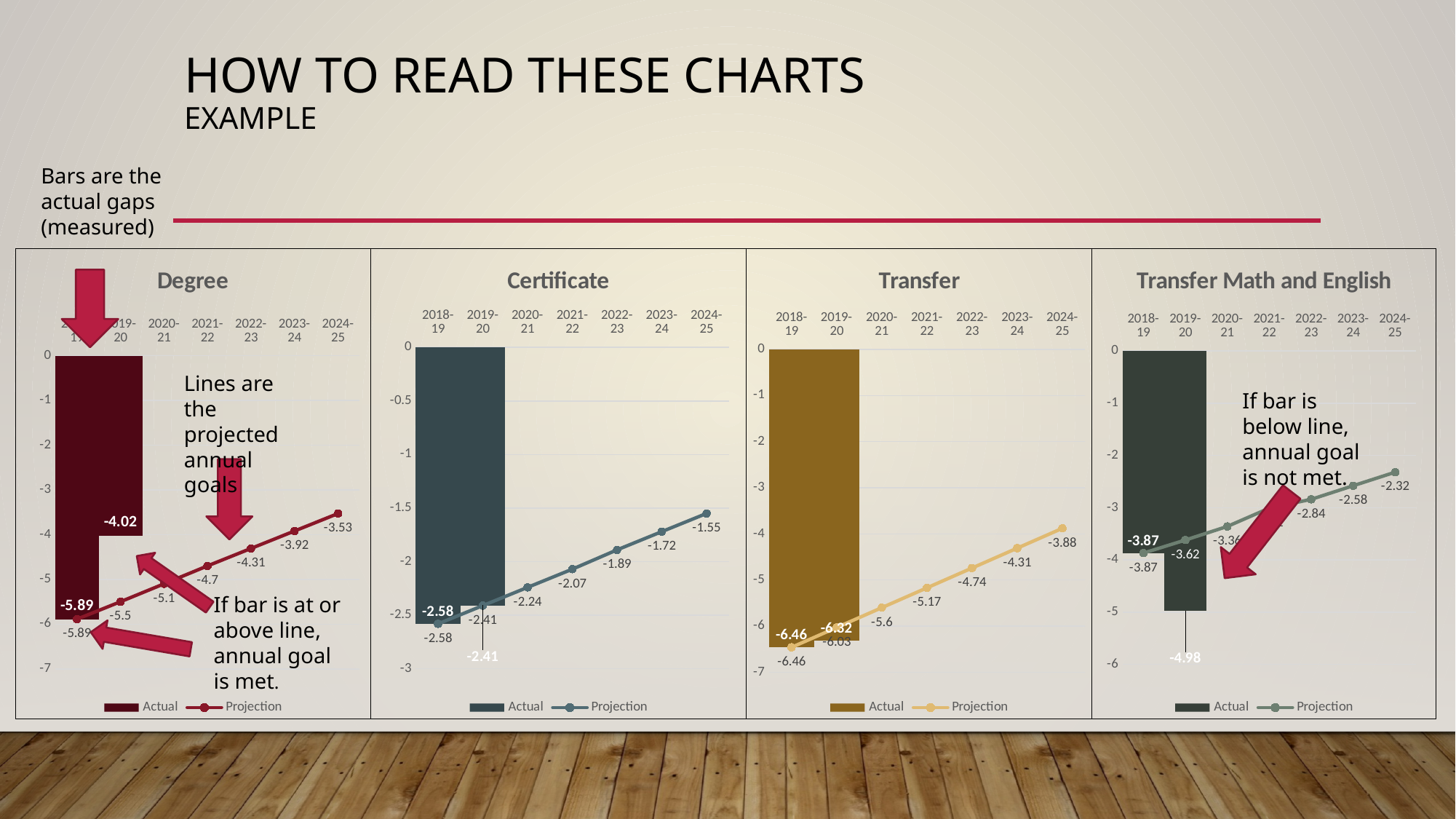
How many series does the legend of the Degree chart list? 2 In the Degree chart, what is the Actual value for 2019-20? -4.02 In the Transfer Math and English chart, which is larger, the Actual value for 2018-19 or the Actual value for 2019-20? 2018-19 In the Degree chart, what is the Projection value for 2024-25? -3.53 In the Certificate chart, what is the Actual value for 2018-19? -2.58 In the Transfer Math and English chart, what is the Actual value for 2019-20? -4.98 In the Transfer chart, what is the difference between the Projection values for 2018-19 and 2024-25? 2.58 In the Certificate chart, what is the Projection value for 2022-23? -1.89 In the Transfer chart, what is the Actual value for 2019-20? -6.32 How many points are plotted on the Projection line in the Transfer chart? 7 In the Certificate chart, does the Projection line rise or fall from 2018-19 to 2024-25? rise What is the title of the rightmost chart on the slide? Transfer Math and English